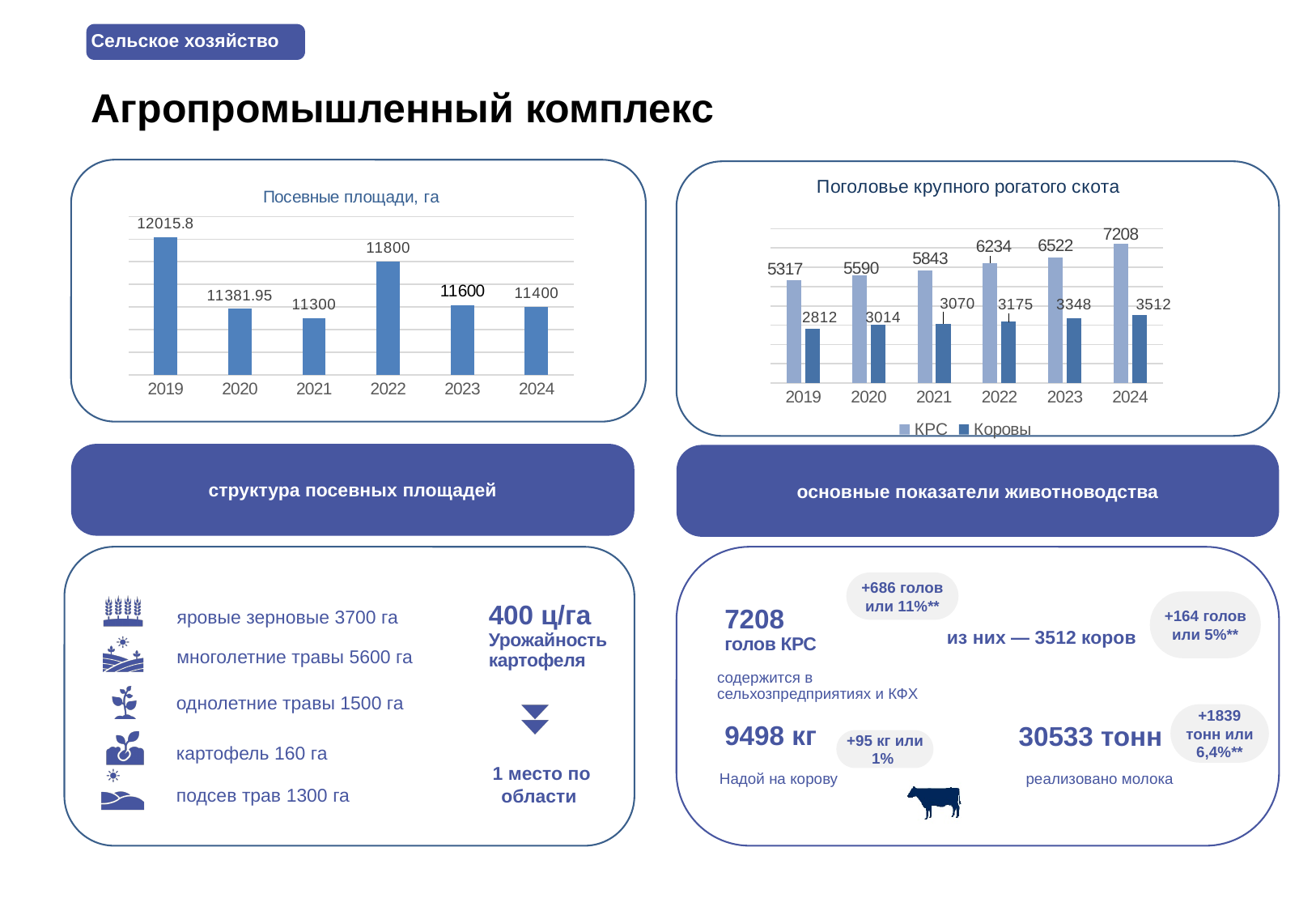
In the chart 'Поголовье крупного рогатого скота', which is larger: Коровы in 2019 or Коровы in 2022? Коровы in 2022 What kind of chart is 'Посевные площади, га'? bar chart In the chart 'Посевные площади, га', what is the value for 2022? 11800 In the chart 'Посевные площади, га', which year has the highest value? 2019 In the chart 'Поголовье крупного рогатого скота', does the КРС series rise or fall from 2019 to 2024? rise In the chart 'Поголовье крупного рогатого скота', what is the difference between КРС in 2024 and КРС in 2023? 686 In the chart 'Посевные площади, га', how many years are shown on the x axis? 6 In the chart 'Поголовье крупного рогатого скота', what is the value of КРС for 2021? 5843 In the chart 'Посевные площади, га', what is the difference between the values for 2022 and 2024? 400 In the chart 'Поголовье крупного рогатого скота', how many series does the legend list? 2 In the chart 'Поголовье крупного рогатого скота', what is the value of Коровы for 2024? 3512 In the chart 'Посевные площади, га', which year has the lowest value? 2021